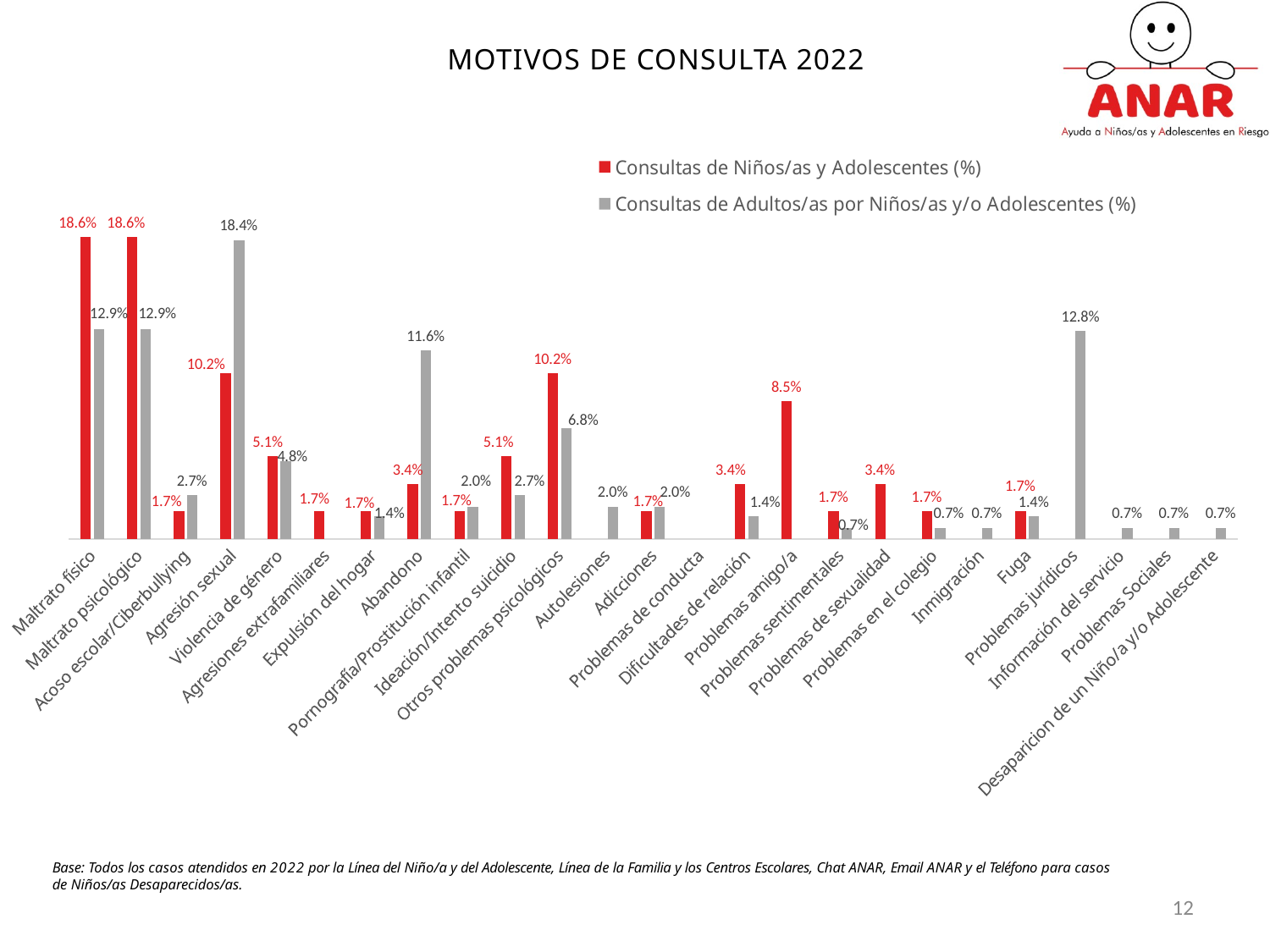
Which colour represents the Consultas de Niños/as y Adolescentes (%) series? Red What is the value for Problemas jurídicos in the Consultas de Adultos/as por Niños/as y/o Adolescentes (%) series? 12.8% What is the difference between the Adultos/as and the Niños/as y Adolescentes values for Agresión sexual? 8.2 percentage points What is the value for Problemas amigo/a in the Consultas de Niños/as y Adolescentes (%) series? 8.5% What is the value for Maltrato físico in the Consultas de Niños/as y Adolescentes (%) series? 18.6% How many series does the legend list? 2 What is the difference between the Adultos/as and the Niños/as y Adolescentes values for Abandono? 8.2 percentage points For Abandono, which series has the larger value: Consultas de Niños/as y Adolescentes or Consultas de Adultos/as por Niños/as y/o Adolescentes? Consultas de Adultos/as por Niños/as y/o Adolescentes Which category has the highest value in the Consultas de Adultos/as por Niños/as y/o Adolescentes (%) series? Agresión sexual What kind of chart is shown on the slide? Bar chart What is the value for Agresión sexual in the Consultas de Adultos/as por Niños/as y/o Adolescentes (%) series? 18.4% For Ideación/Intento suicidio, which series has the larger value: Consultas de Niños/as y Adolescentes or Consultas de Adultos/as por Niños/as y/o Adolescentes? Consultas de Niños/as y Adolescentes